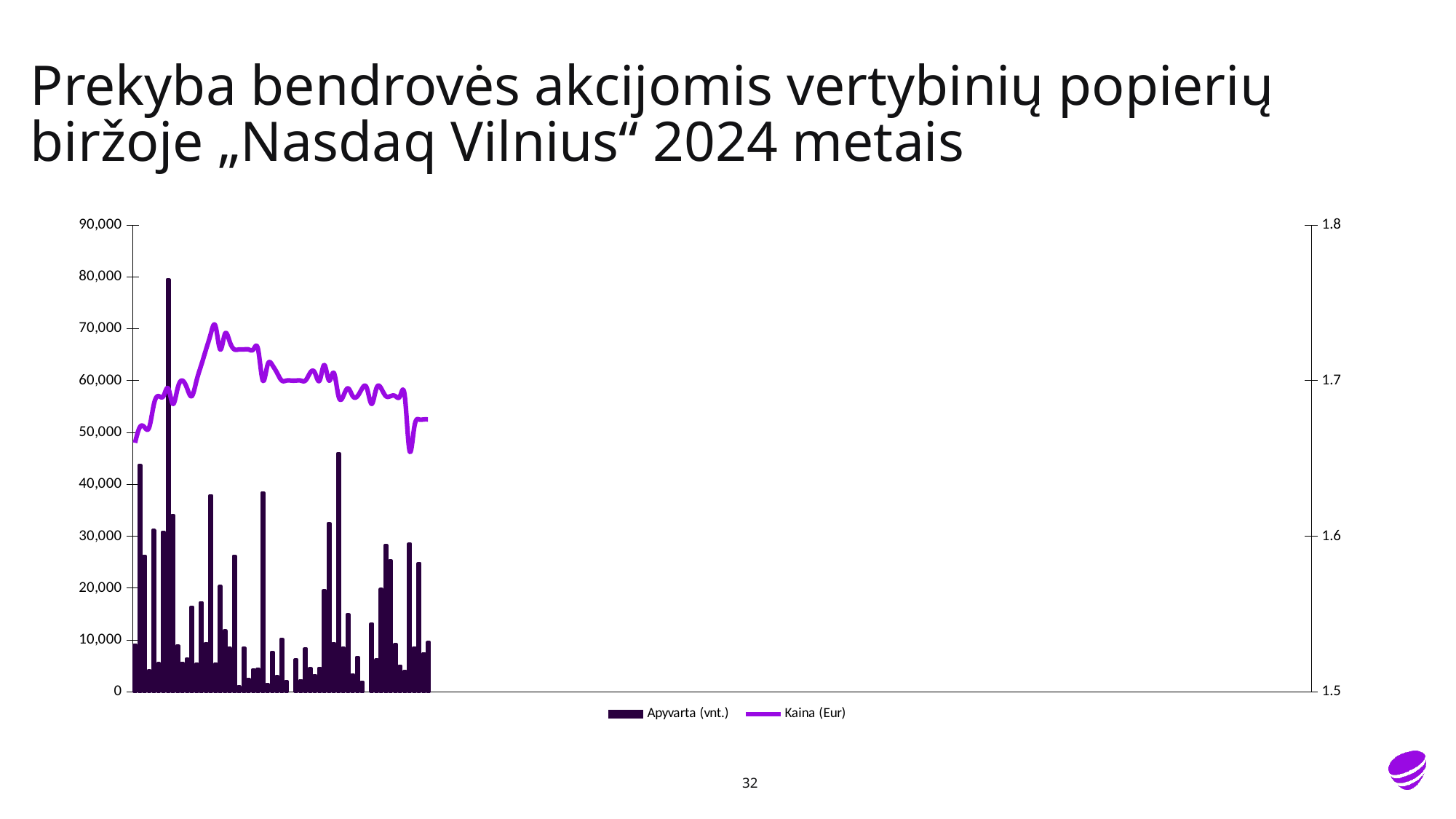
Is the highest point of the Kaina (Eur) line greater or less than 1.7? greater How many series does the chart legend list? 2 Is the Kaina (Eur) value at the end of the chart greater or less than 1.6? greater Which series is drawn as bars, Apyvarta (vnt.) or Kaina (Eur)? Apyvarta (vnt.) Is the tallest Apyvarta (vnt.) bar greater or less than 90,000? less What are the two series named in the chart legend? Apyvarta (vnt.) and Kaina (Eur) What kind of chart is shown on the slide? Combination bar and line chart Does the Kaina (Eur) line rise or fall from its peak to the end of the chart? fall